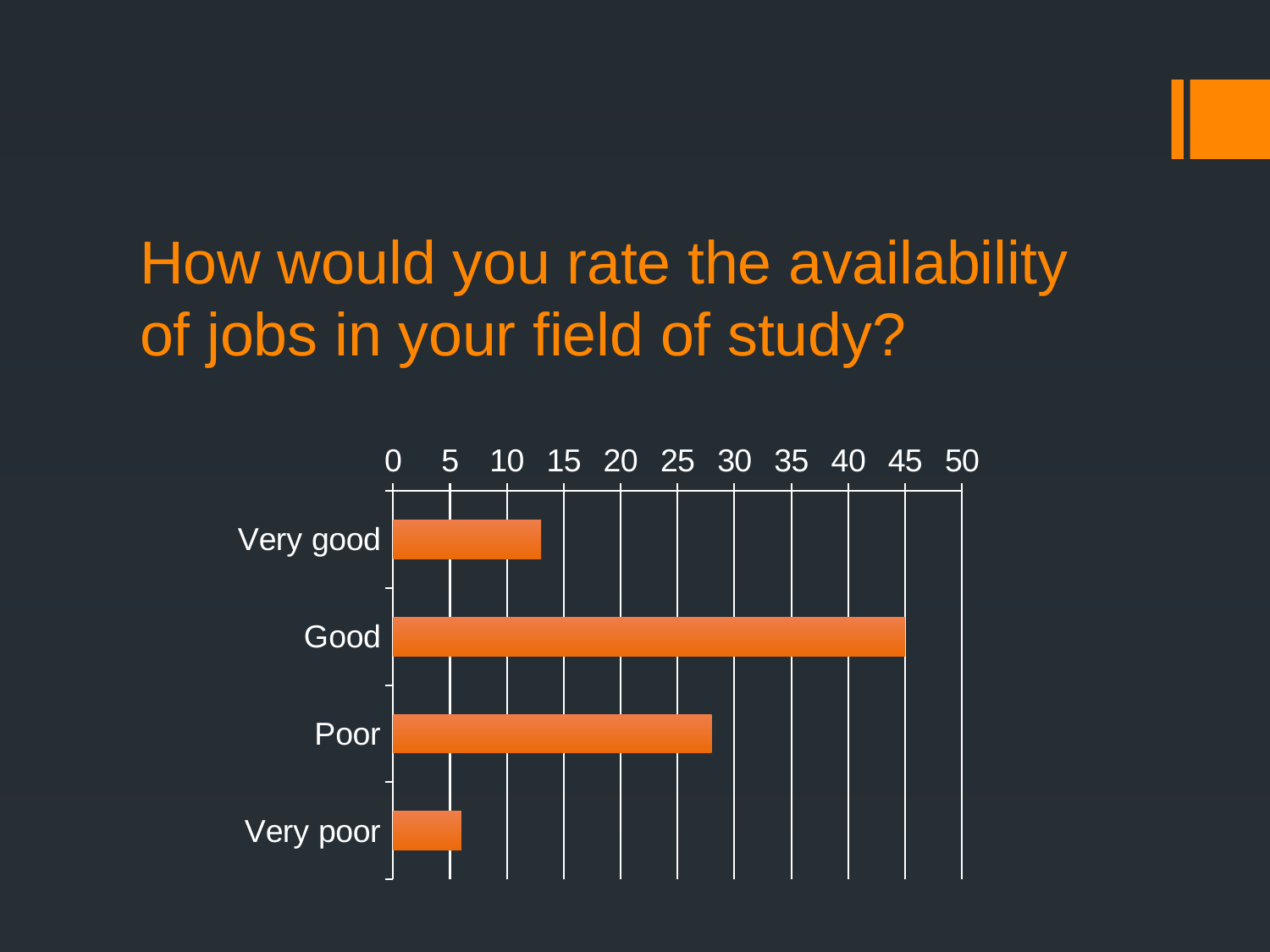
What is the value for Good? 45 Is the value for Very poor greater or less than 10? less Which category has the lowest value? Very poor What kind of chart is shown on the slide? bar chart Is the value for Very good greater or less than 15? less How many categories are shown in the chart? 4 Is the value for Very good greater or less than 10? greater What is the title of the slide containing the chart? How would you rate the availability of jobs in your field of study? Which is larger, the value for Poor or the value for Very good? Poor Which category has the highest value? Good What is the maximum value shown on the horizontal axis? 50